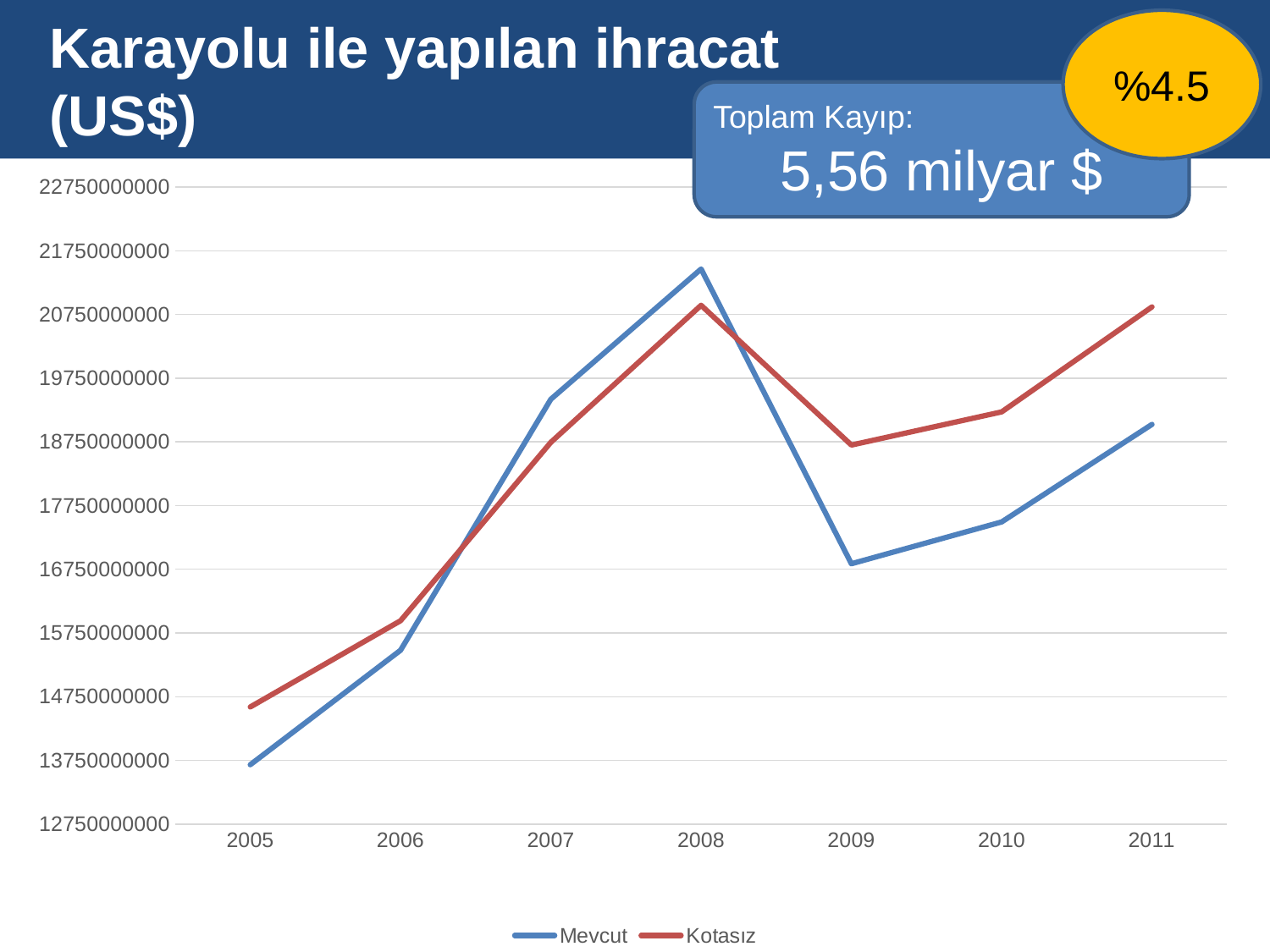
How many years are plotted along the x axis? 7 Is the value for Kotasız in 2010 greater or less than 18750000000? greater Do the values of the Mevcut series rise or fall from 2008 to 2009? fall How many series does the legend list? 2 In 2011, which series has the larger value, Mevcut or Kotasız? Kotasız What are the two series names shown in the legend? Mevcut and Kotasız What kind of chart is shown on the slide? line chart In which year does the Mevcut series reach its highest value? 2008 Is the value for Mevcut in 2010 greater or less than 17750000000? less Do the values of the Mevcut series rise or fall from 2005 to 2008? rise In which year does the Mevcut series have its lowest value? 2005